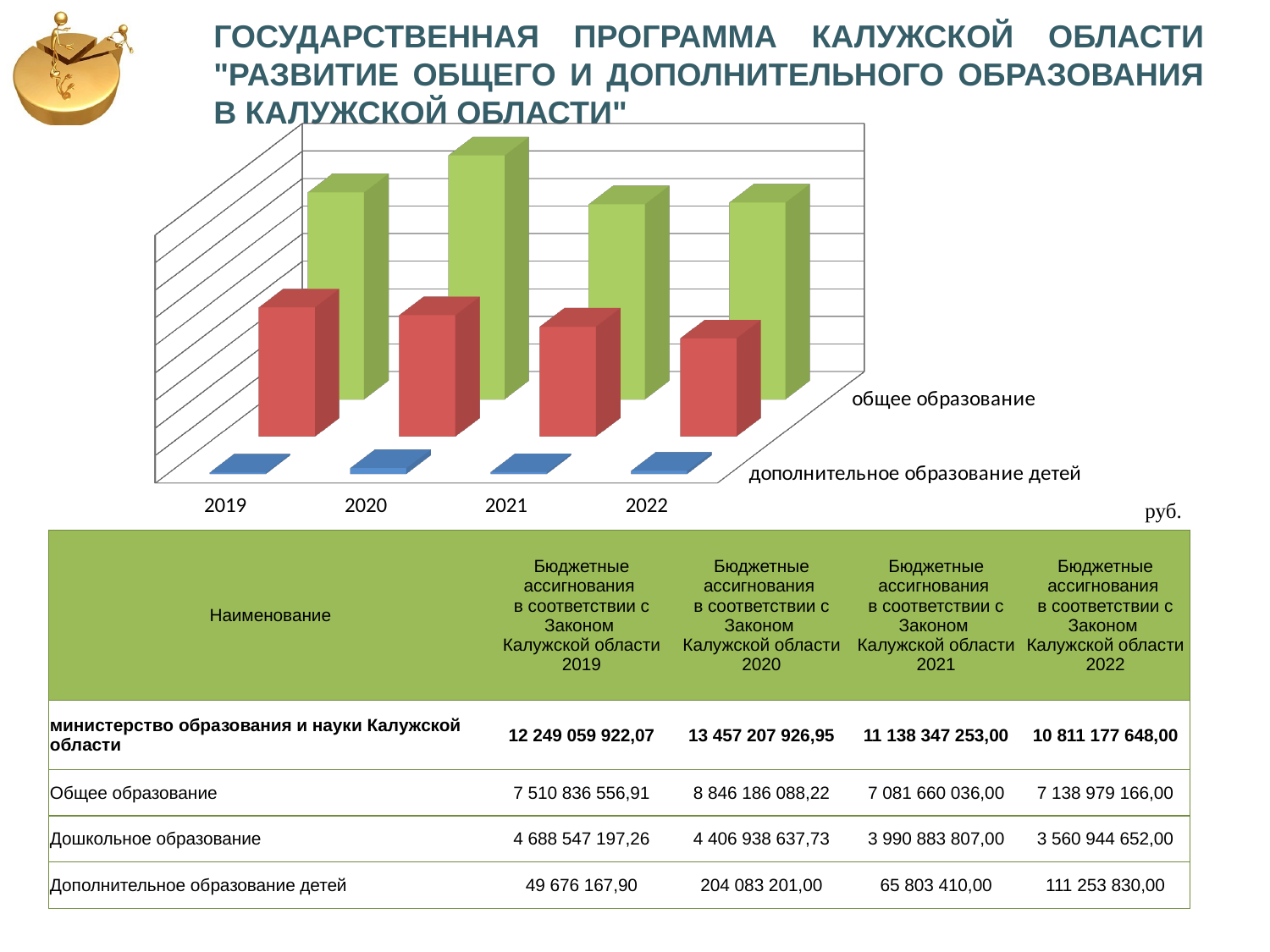
According to the table below the chart, what is the value for Общее образование in 2020? 8 846 186 088,22 In which year is the bar for общее образование the tallest? 2020 Which is taller: the bar for общее образование in 2020 or in 2021? 2020 In 2019, which is larger: the bar for общее образование or the red bar? общее образование What kind of chart is shown on the slide? bar chart How many years are shown along the x axis of the chart? 4 What is the first year shown on the x axis of the chart? 2019 What series label is shown next to the green bars in the chart? общее образование According to the table below the chart, what is the value for Дополнительное образование детей in 2019? 49 676 167,90 Do the red bars rise or fall from 2019 to 2022? fall Which is taller: the red bar for 2019 or the red bar for 2022? 2019 Which series has the smallest bars in every year of the chart? дополнительное образование детей